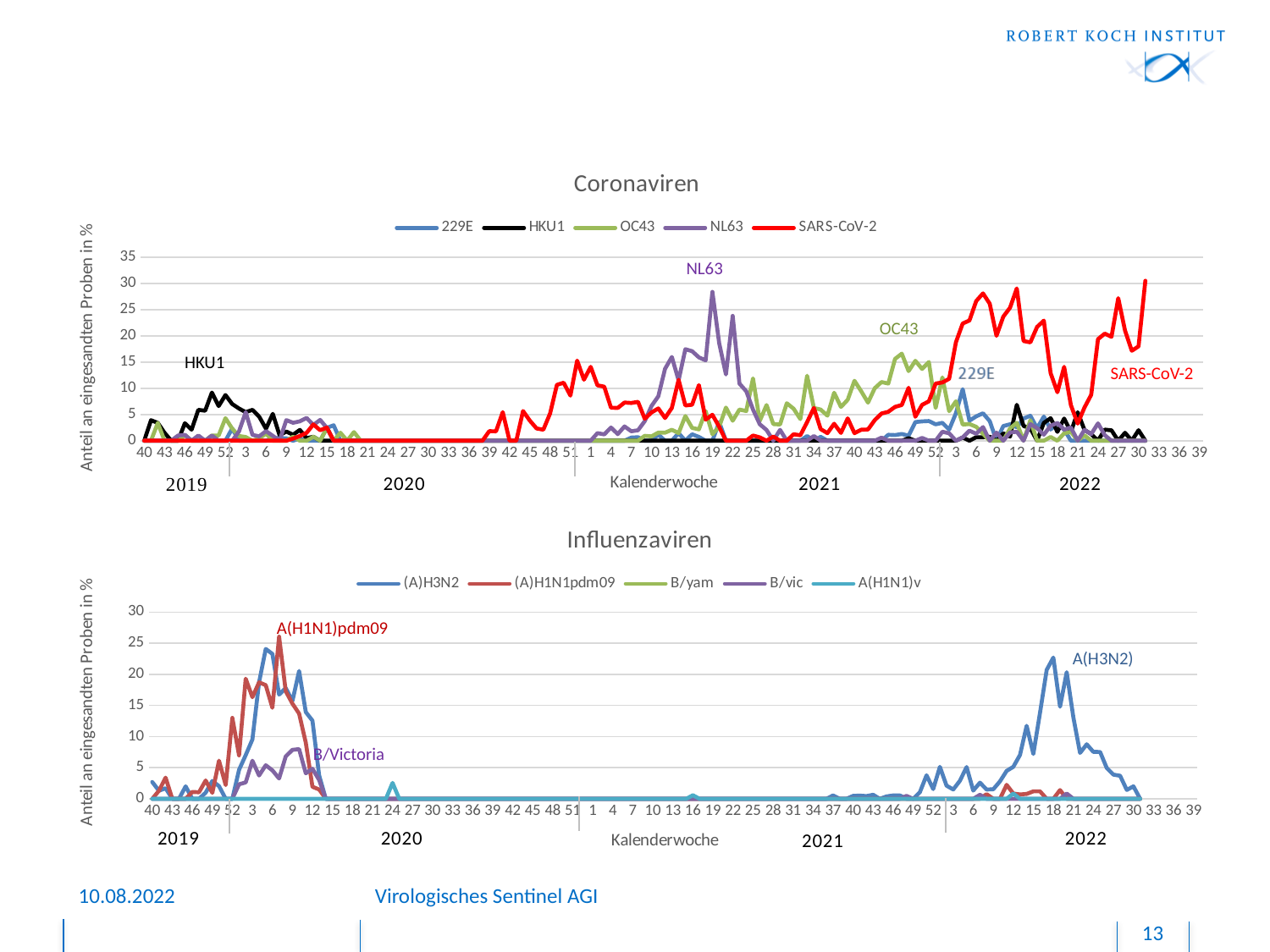
In the Influenzaviren chart, is the peak value of A(H1N1)pdm09 in 2019 greater or less than 20? less In the Coronaviren chart, is the peak value of NL63 in 2020 greater or less than 25? less How many series does the legend of the Influenzaviren chart list? 5 In the Coronaviren chart, is the peak value of HKU1 in 2019 greater or less than 15? less What is the x-axis label of the Influenzaviren chart? Kalenderwoche What is the y-axis label of the Coronaviren chart? Anteil an eingesandten Proben in % How many series does the legend of the Coronaviren chart list? 5 What type of chart is the Coronaviren chart? line chart